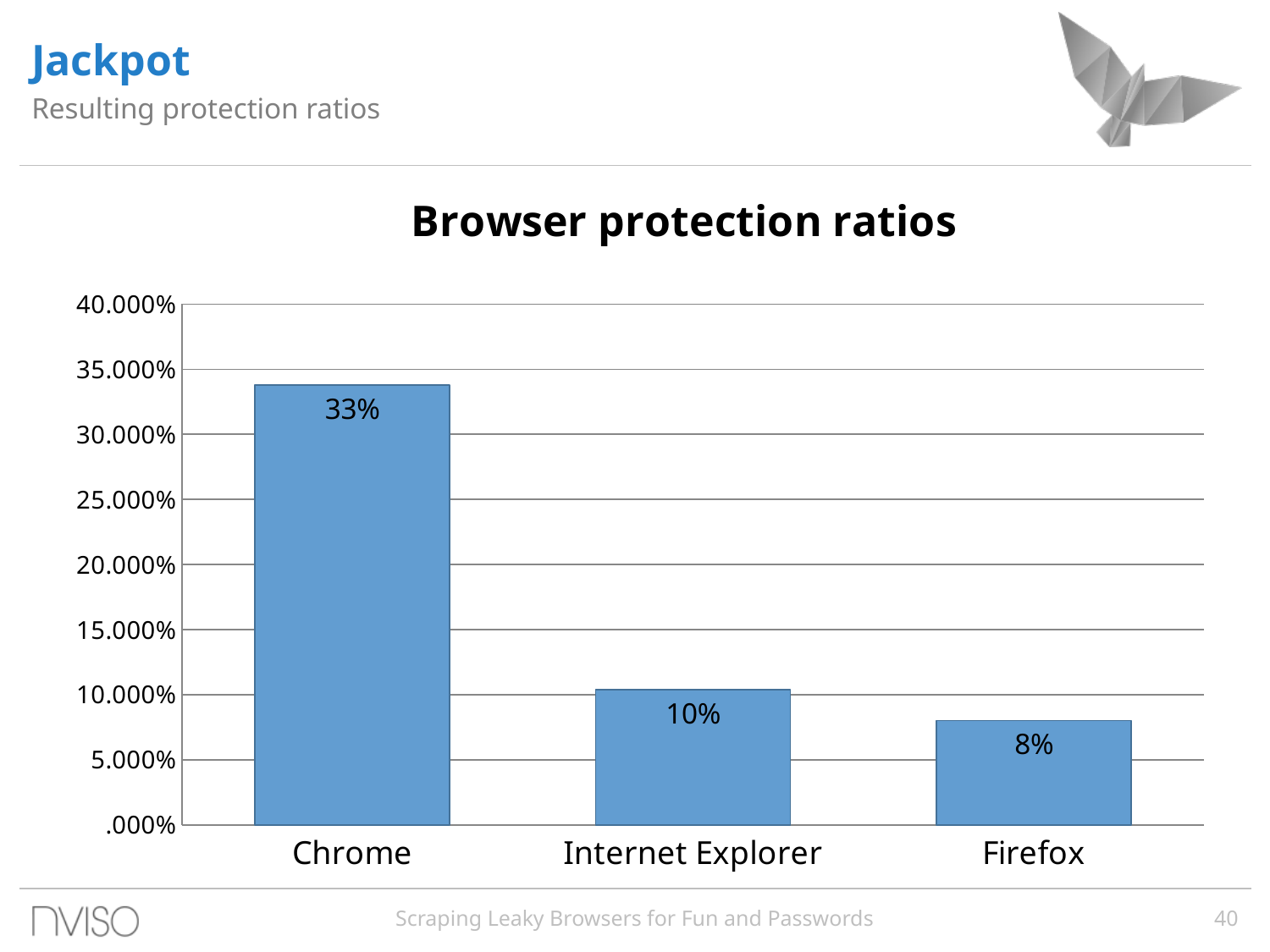
What is the title of the chart? Browser protection ratios What is the protection ratio shown for Chrome? 33% Which browser has the lowest protection ratio? Firefox How many browsers are shown in the chart? 3 Which browser has the highest protection ratio? Chrome What is the protection ratio shown for Internet Explorer? 10% What is the protection ratio shown for Firefox? 8% What kind of chart is shown on the slide? Bar chart What is the difference between the labelled protection ratios of Internet Explorer and Firefox? 2% What is the difference between the labelled protection ratios of Chrome and Internet Explorer? 23% Which has a larger protection ratio, Internet Explorer or Firefox? Internet Explorer Is the value for Chrome greater or less than 30.000%? greater